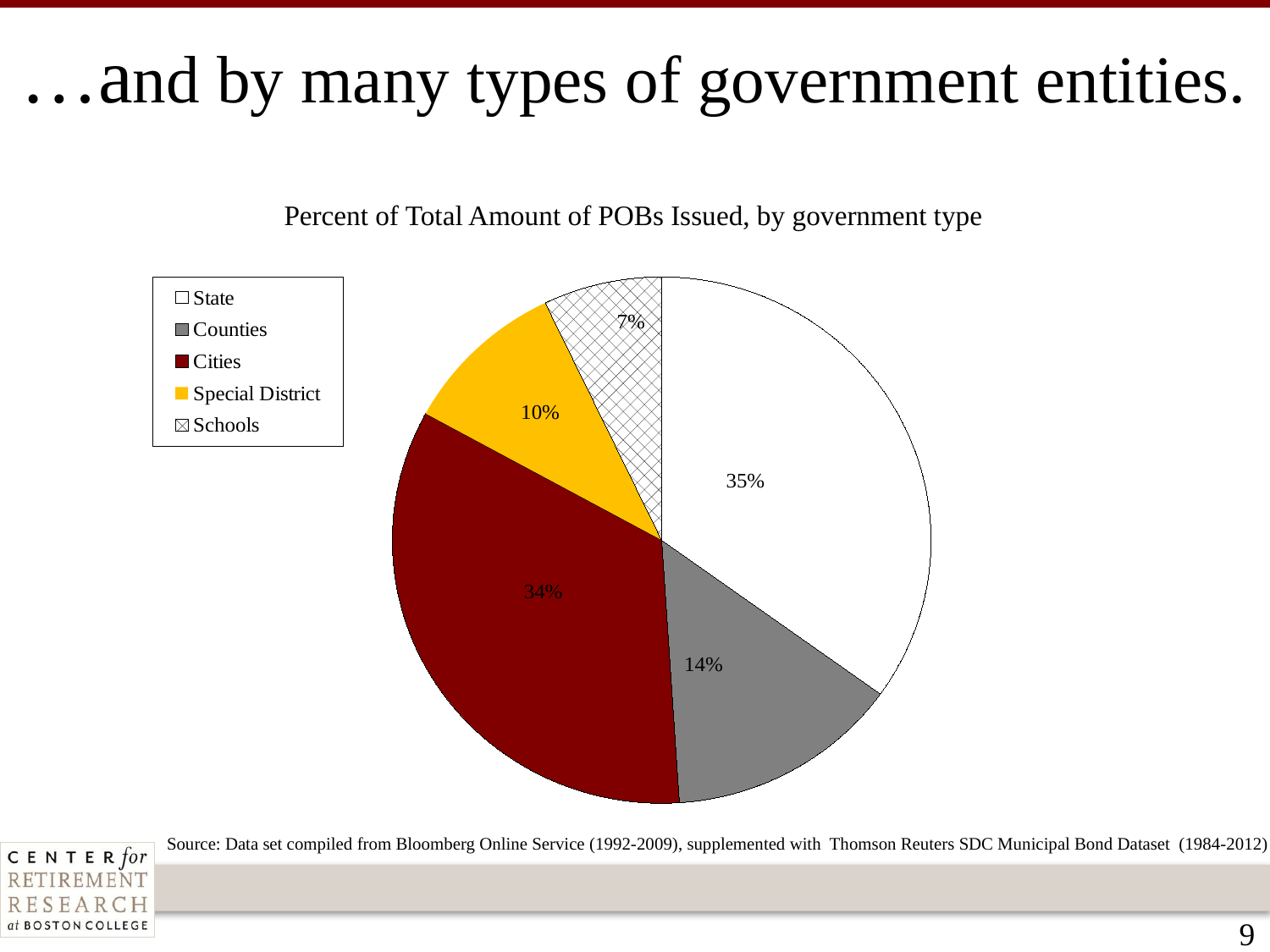
What percentage of the total amount of POBs issued is attributed to State? 35% Which government type has the smallest share of POBs issued? Schools What is the difference in percentage points between the Counties share and the Schools share? 7 What percentage of the total amount of POBs issued is attributed to Schools? 7% What percentage of the total amount of POBs issued is attributed to Special District? 10% How many government types are shown in the pie chart? 5 Which government type has the largest share of POBs issued? State What percentage of the total amount of POBs issued is attributed to Cities? 34% What type of chart is shown on the slide? pie chart What percentage of the total amount of POBs issued is attributed to Counties? 14% Which has a larger share of POBs issued, Counties or Special District? Counties What is the title of the chart? Percent of Total Amount of POBs Issued, by government type